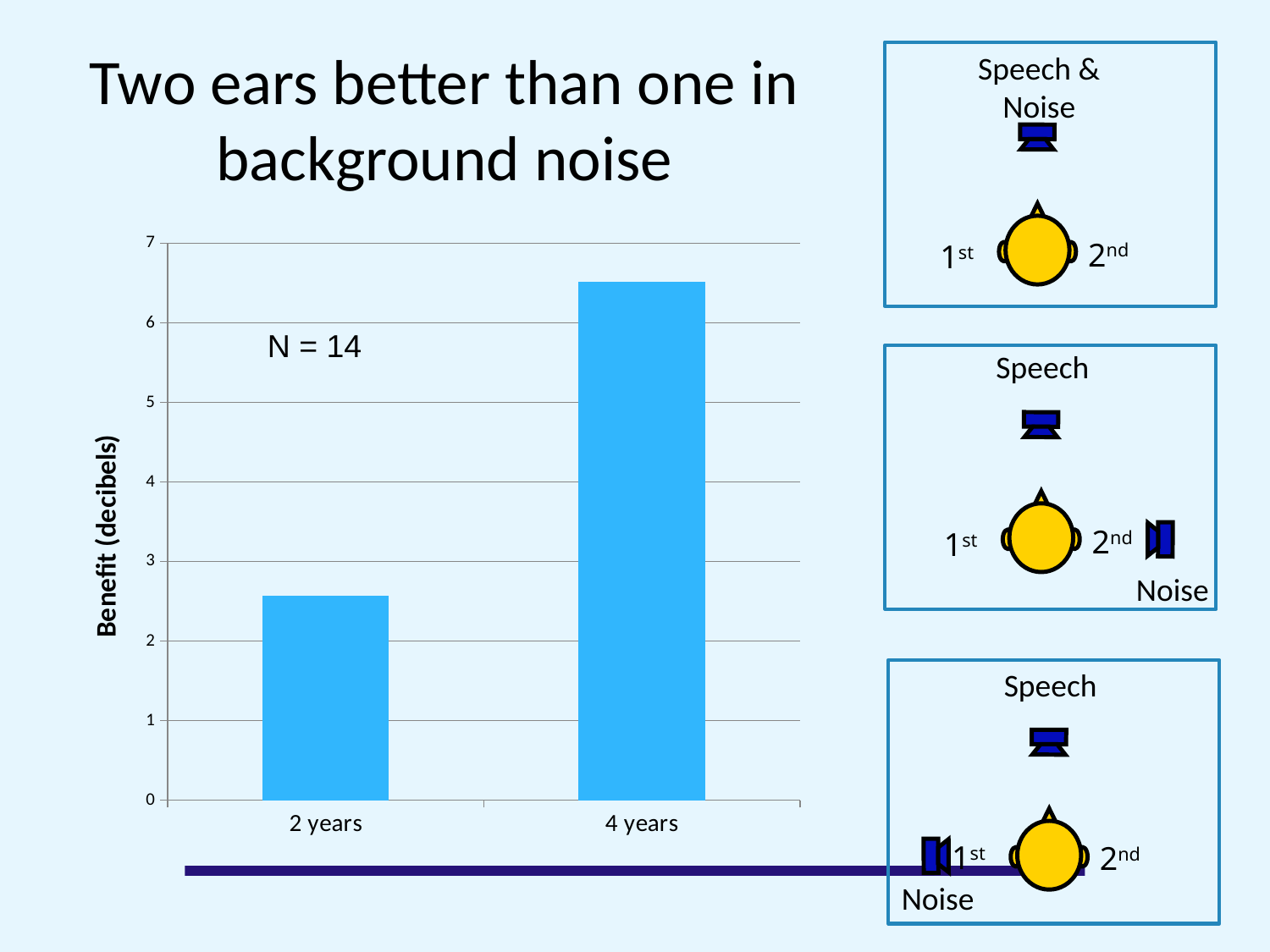
What is the label on the vertical axis of the chart? Benefit (decibels) Is the benefit for 2 years greater or less than 2 decibels? greater What kind of chart is shown on the slide? bar chart Which is larger, the benefit for 2 years or for 4 years? 4 years Which category has the lowest benefit in the chart? 2 years How many categories are plotted on the x axis of the chart? 2 Is the benefit for 2 years greater or less than 3 decibels? less Is the benefit for 4 years greater or less than 6 decibels? greater Do the values rise or fall from 2 years to 4 years? rise What sample size is annotated on the chart? N = 14 Which category has the highest benefit in the chart? 4 years